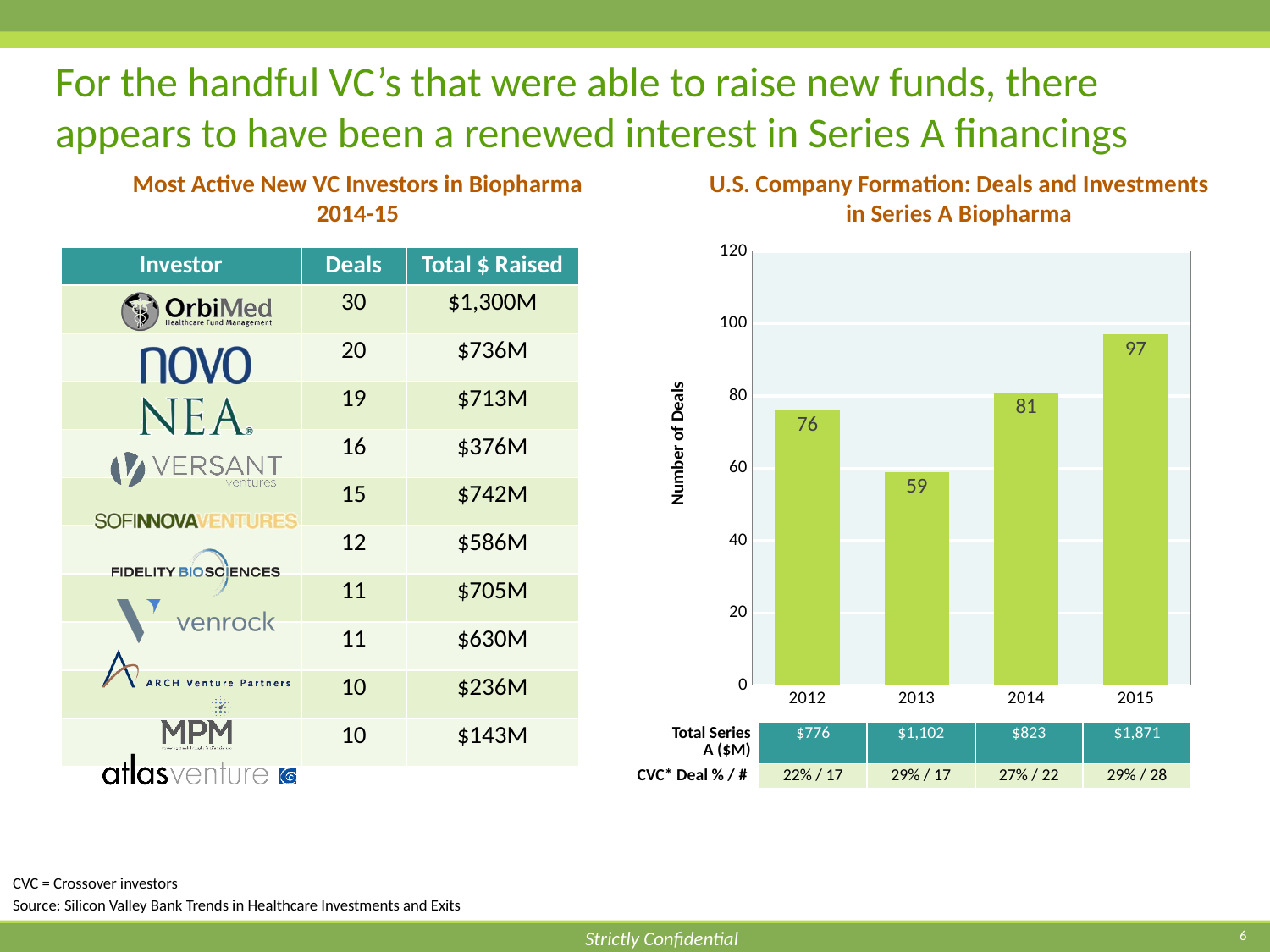
In the 'U.S. Company Formation' chart, what is the number of deals in 2015? 97 What is the y-axis label of the 'U.S. Company Formation' chart? Number of Deals In the 'U.S. Company Formation' chart, what is the number of deals in 2012? 76 In the 'U.S. Company Formation' chart, which year has the highest number of deals? 2015 In the 'U.S. Company Formation' chart, which year has the lowest number of deals? 2013 In the 'U.S. Company Formation' chart, what is the number of deals in 2013? 59 In the 'U.S. Company Formation' chart, which year had more deals, 2012 or 2014? 2014 What type of chart is shown under the title 'U.S. Company Formation: Deals and Investments in Series A Biopharma'? Bar chart In the 'U.S. Company Formation' chart, what is the difference in number of deals between 2015 and 2014? 16 How many years are shown on the x axis of the 'U.S. Company Formation' chart? 4 In the 'U.S. Company Formation' chart, did the number of deals rise or fall from 2013 to 2015? Rise In the 'U.S. Company Formation' chart, is the number of deals in 2013 greater or less than 60? less